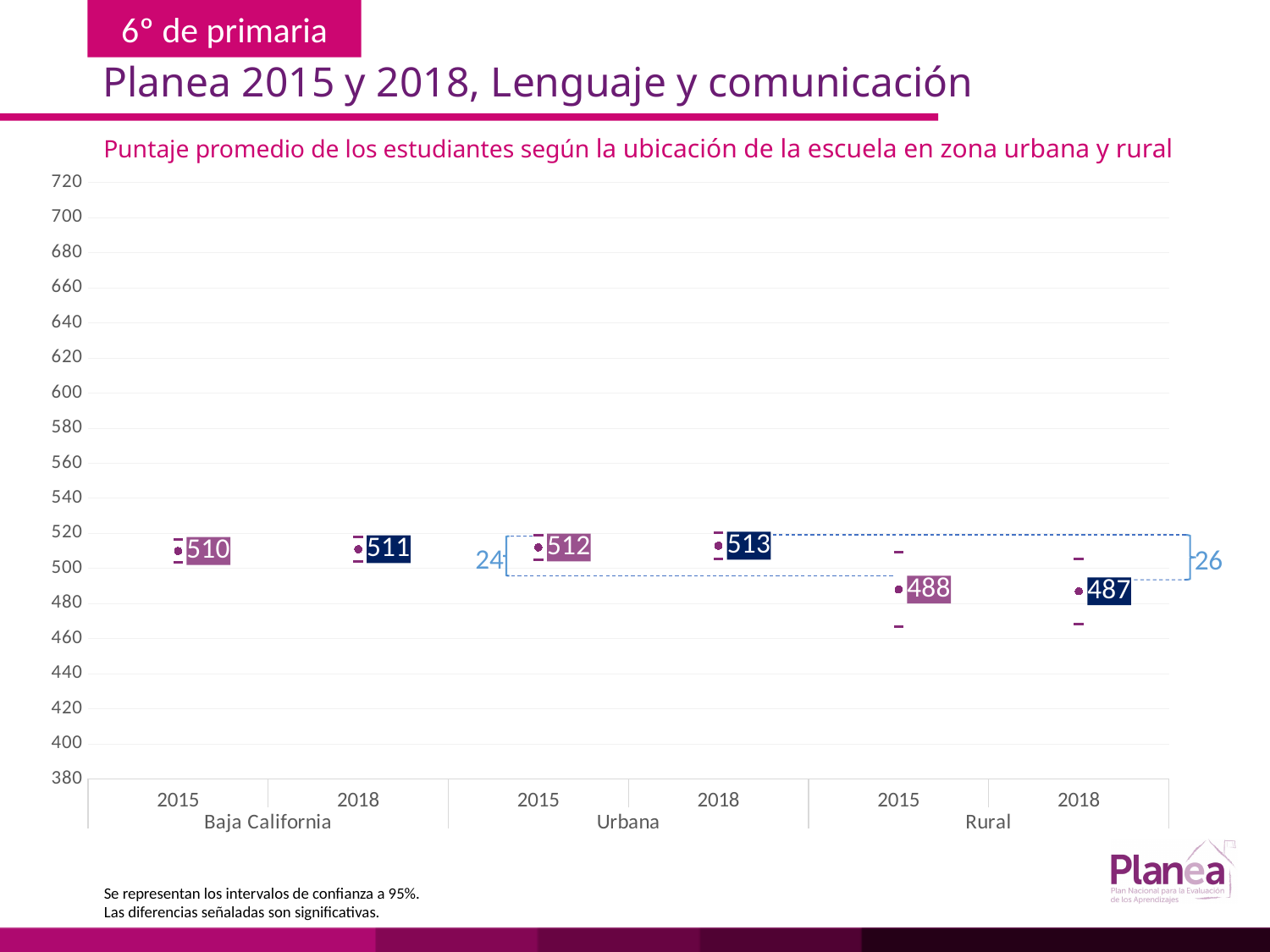
Which group and year has the highest average score? Urbana 2018 Which group and year has the lowest average score? Rural 2018 How many data points are plotted on the chart? 6 What is the average score for Rural schools in 2015? 488 What is the average score for Urbana schools in 2018? 513 What is the average score for Baja California in 2015? 510 What is the average score for Rural schools in 2018? 487 Which is larger, the Urbana 2015 score or the Rural 2015 score? Urbana 2015 What is the average score for Urbana schools in 2015? 512 What is the average score for Baja California in 2018? 511 What is the difference between the Urbana and Rural average scores in 2018? 26 What is the difference between the Urbana and Rural average scores in 2015? 24